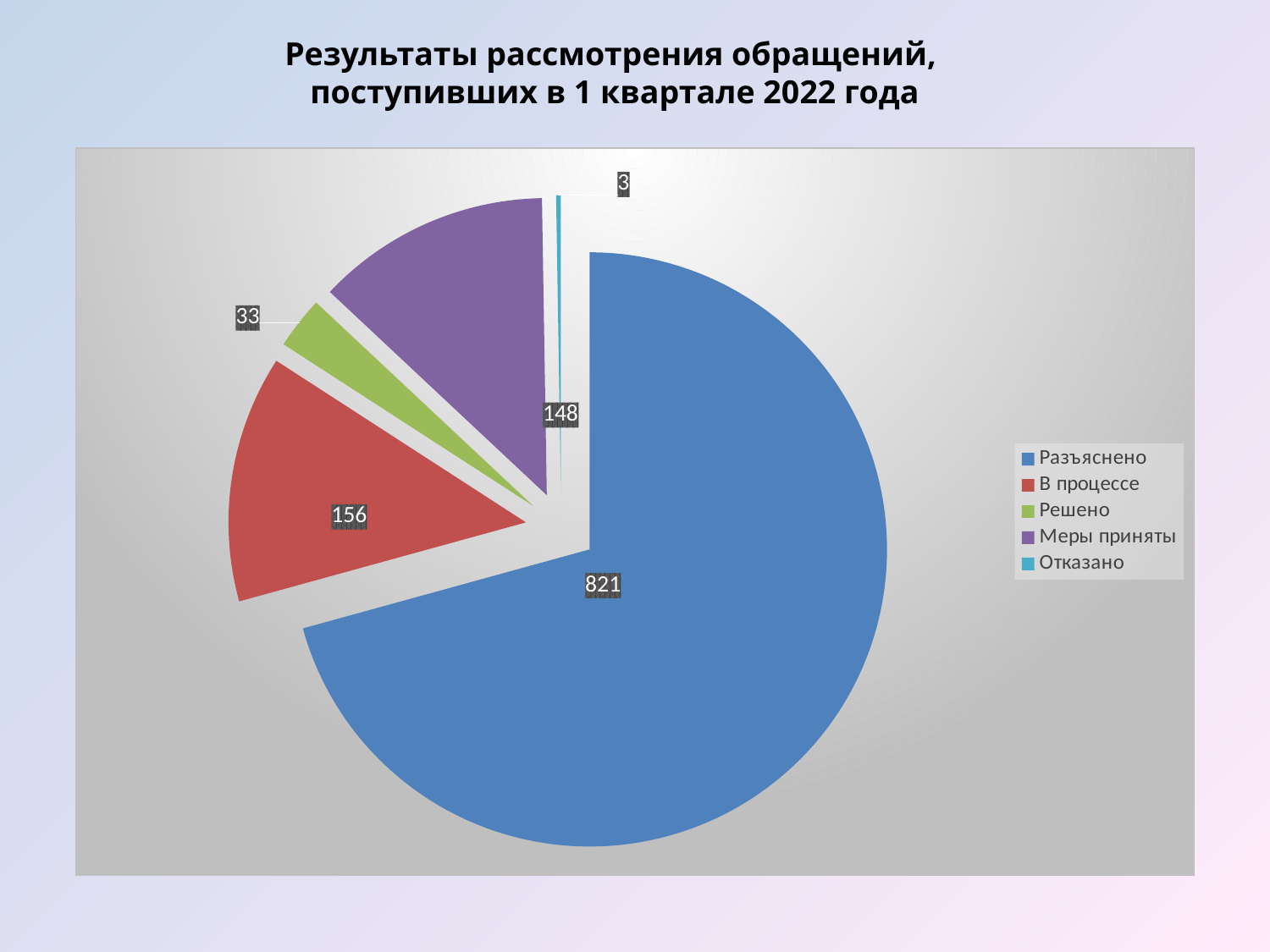
Which category has the smallest slice? Отказано What is the title of the chart? Результаты рассмотрения обращений, поступивших в 1 квартале 2022 года What is the value for Меры приняты? 148 Which is larger, the value for В процессе or the value for Меры приняты? В процессе Which category has the largest slice? Разъяснено What is the value for Решено? 33 What type of chart is shown on the slide? pie chart How many categories does the legend list? 5 What is the value for Разъяснено? 821 What is the difference between the values for В процессе and Меры приняты? 8 What is the value for Отказано? 3 What is the value for В процессе? 156